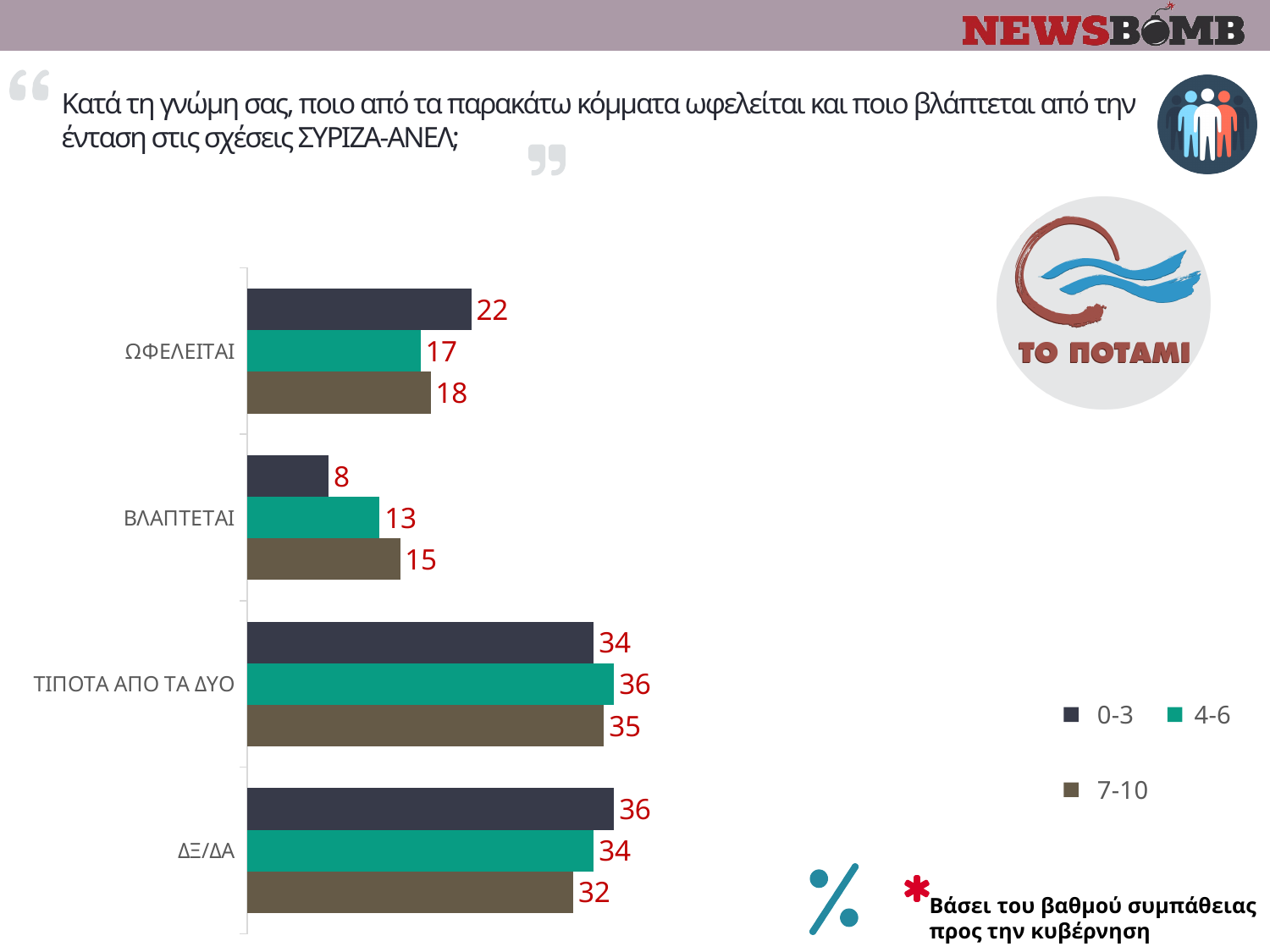
Which category has the lowest value in the 0-3 series? ΒΛΑΠΤΕΤΑΙ How many series does the legend list? 3 What is the value for ΒΛΑΠΤΕΤΑΙ in the 7-10 series? 15 What is the value for ΔΞ/ΔΑ in the 7-10 series? 32 What is the value for ΤΙΠΟΤΑ ΑΠΟ ΤΑ ΔΥΟ in the 4-6 series? 36 How many categories are shown on the chart? 4 What kind of chart is shown on the slide? Bar chart What is the difference between the 0-3 and 4-6 values for ΩΦΕΛΕΙΤΑΙ? 5 Which colour represents the 4-6 series in the legend? Green Which category has the highest value in the 0-3 series? ΔΞ/ΔΑ What is the value for ΩΦΕΛΕΙΤΑΙ in the 0-3 series? 22 For ΒΛΑΠΤΕΤΑΙ, which series has the larger value, 0-3 or 4-6? 4-6